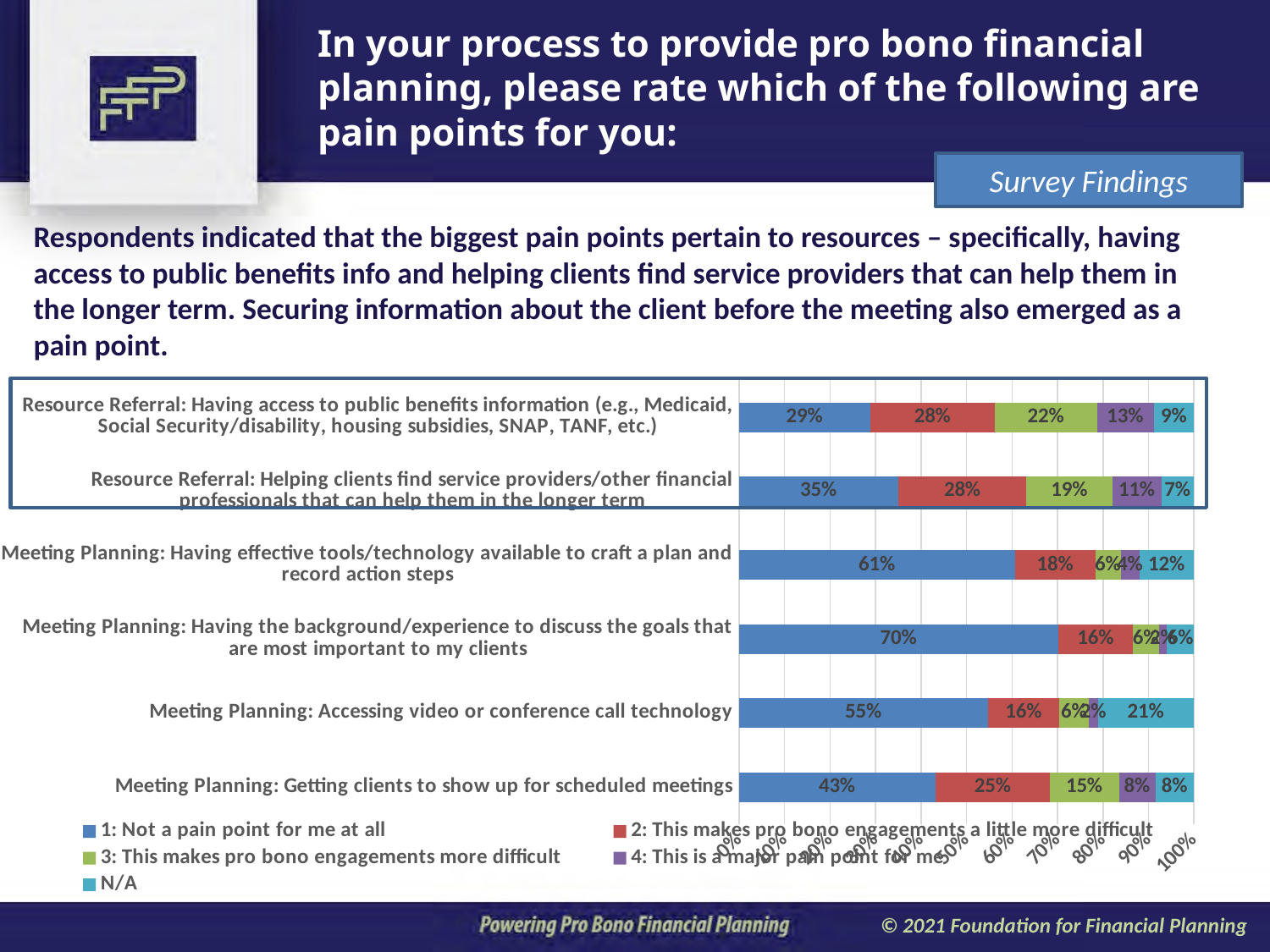
Which has a larger share of respondents rating it a major pain point (rating 4): 'Resource Referral: Having access to public benefits information' or 'Meeting Planning: Getting clients to show up for scheduled meetings'? Resource Referral: Having access to public benefits information What percentage of respondents said 'Resource Referral: Having access to public benefits information' is not a pain point for them at all? 29% What type of chart is shown on the slide? Stacked bar chart How many series does the chart legend list? 5 What percentage of respondents rated 'Meeting Planning: Getting clients to show up for scheduled meetings' as '2: This makes pro bono engagements a little more difficult'? 25% Which pain point has the lowest percentage of respondents saying it is not a pain point at all? Resource Referral: Having access to public benefits information Which pain point has the highest percentage of respondents saying it is not a pain point at all? Meeting Planning: Having the background/experience to discuss the goals that are most important to my clients What is the difference between the 'Not a pain point at all' percentages for 'Meeting Planning: Having the background/experience' (70%) and 'Meeting Planning: Getting clients to show up' (43%)? 27% What is the N/A percentage for 'Meeting Planning: Accessing video or conference call technology'? 21% What percentage of respondents said 'Resource Referral: Helping clients find service providers/other financial professionals' is a major pain point (rating 4)? 11% Which legend entry is shown in green? 3: This makes pro bono engagements more difficult How many pain point categories are shown in the chart? 6